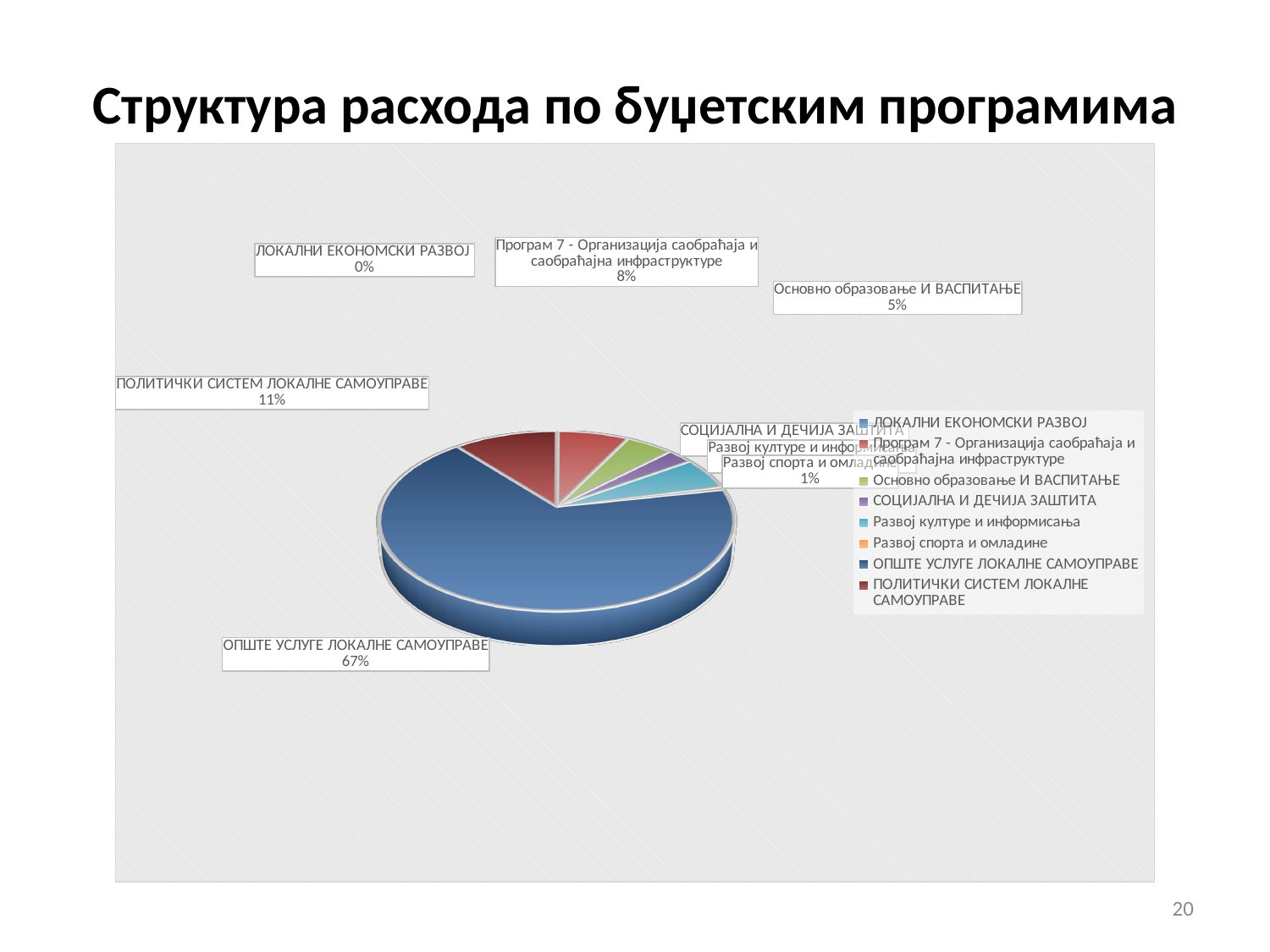
What kind of chart is shown on the slide? pie chart What is the title of the slide? Структура расхода по буџетским програмима How many entries does the legend list? 8 What share of the pie is ОПШТЕ УСЛУГЕ ЛОКАЛНЕ САМОУПРАВЕ? 67% What share of the pie is Основно образовање И ВАСПИТАЊЕ? 5% Which category has the largest share of the pie? ОПШТЕ УСЛУГЕ ЛОКАЛНЕ САМОУПРАВЕ Which has a larger share: Основно образовање И ВАСПИТАЊЕ or Програм 7 - Организација саобраћаја и саобраћајна инфраструктура? Програм 7 - Организација саобраћаја и саобраћајна инфраструктура What share of the pie is ЛОКАЛНИ ЕКОНОМСКИ РАЗВОЈ? 0% What share of the pie is ПОЛИТИЧКИ СИСТЕМ ЛОКАЛНЕ САМОУПРАВЕ? 11% What share of the pie is Програм 7 - Организација саобраћаја и саобраћајна инфраструктура? 8% Which category has the smallest share of the pie? ЛОКАЛНИ ЕКОНОМСКИ РАЗВОЈ What is the difference in percentage points between ПОЛИТИЧКИ СИСТЕМ ЛОКАЛНЕ САМОУПРАВЕ and Програм 7 - Организација саобраћаја и саобраћајна инфраструктура? 3